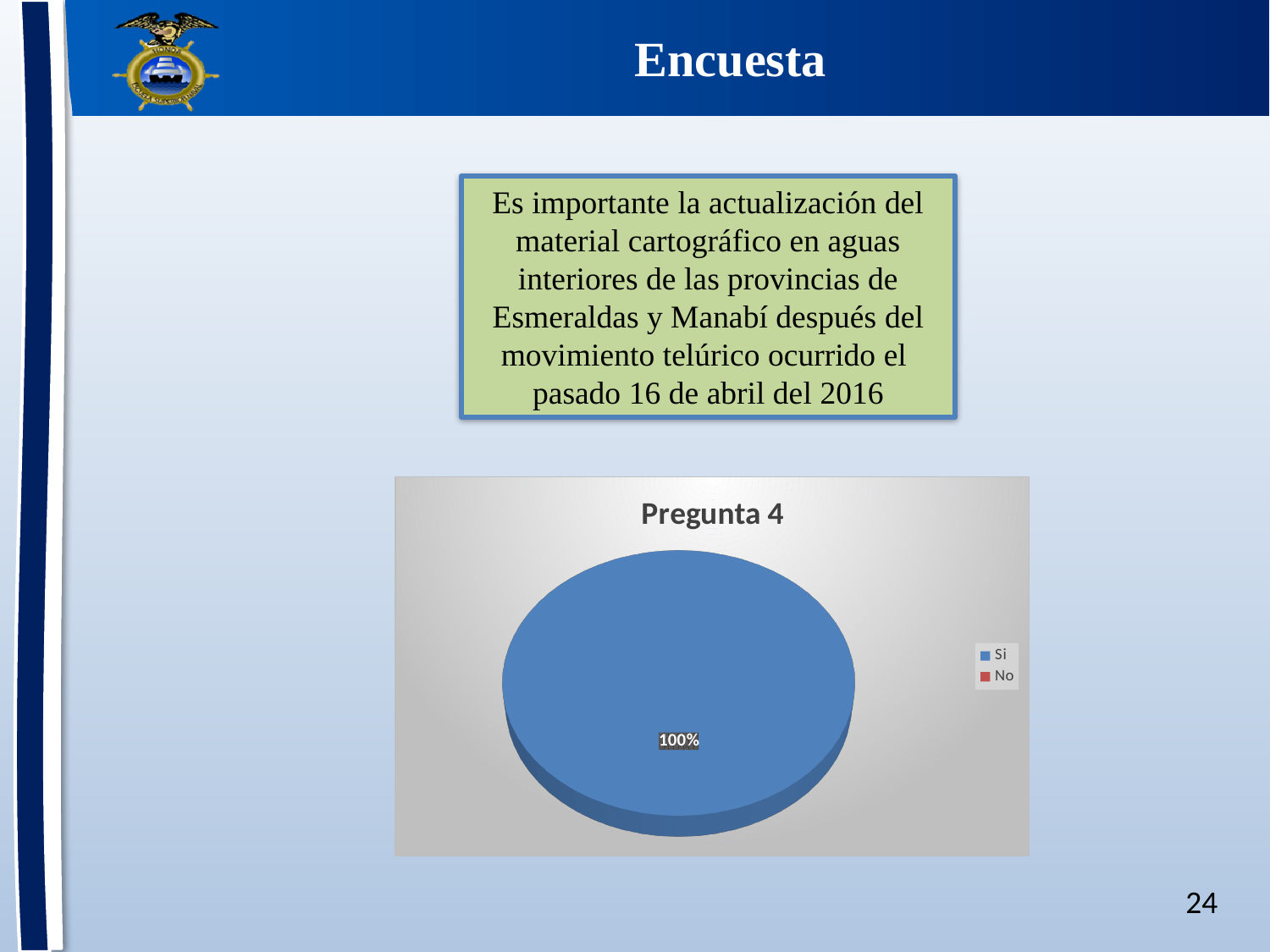
What kind of chart is shown on the slide? pie chart Which category has the smallest share of the pie? No What percentage is shown for the Si slice? 100% What is the title of the chart? Pregunta 4 How many entries does the legend list? 2 Is the share for Si greater or less than 50%? greater Which category has the largest share of the pie? Si Which is larger, the share for Si or the share for No? Si What colour is the Si slice in the legend? blue What share of the pie does the Si slice take? 100%